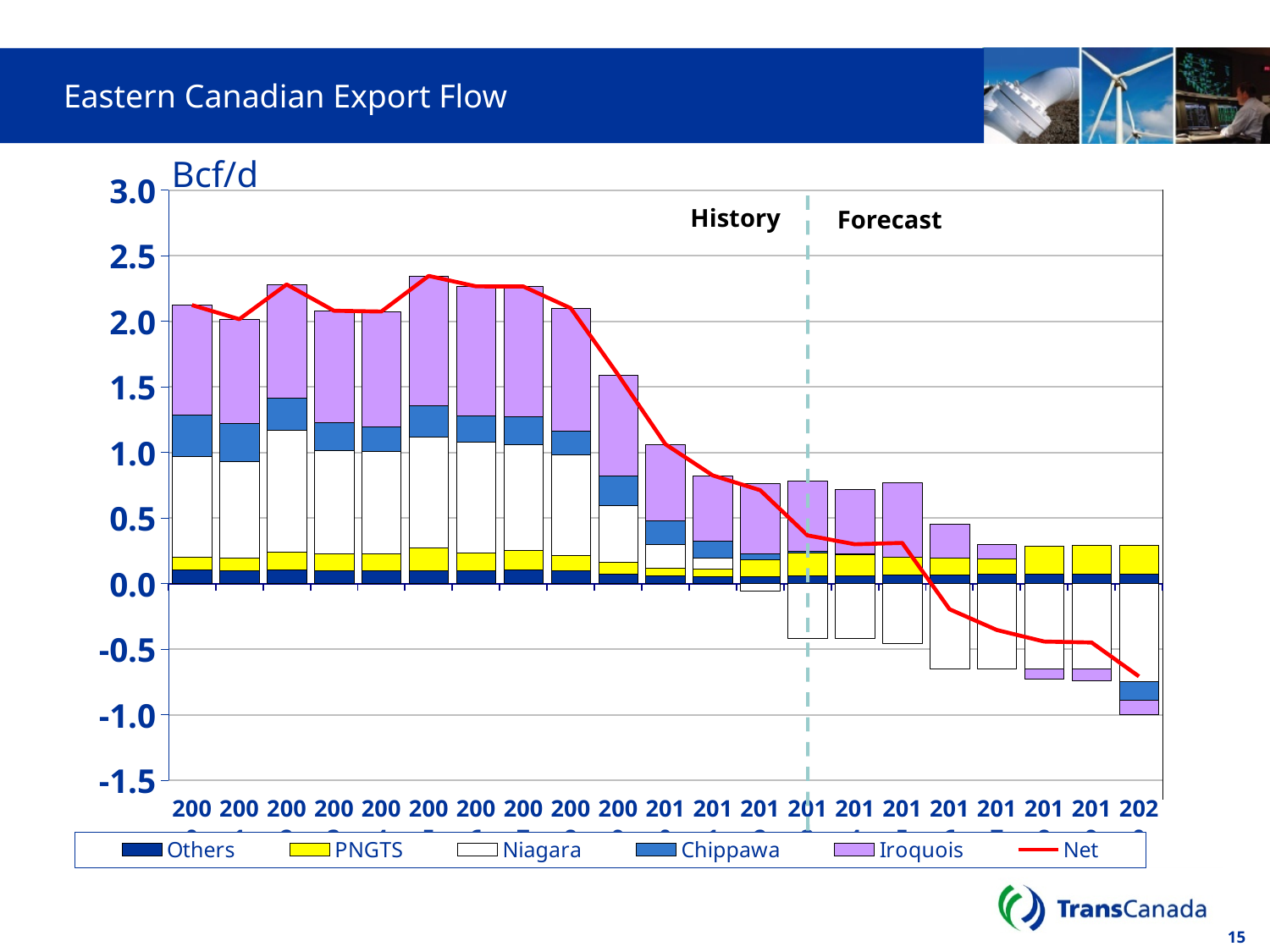
What kind of chart is shown on the slide? stacked bar chart with a line Which series is plotted as a red line rather than as bars? Net How many series does the legend list? 6 Is the Net value for the leftmost year greater or less than 1.5? greater Does the Net line rise or fall overall from the leftmost year to the rightmost year? fall Is the Net value at the dashed History/Forecast boundary greater or less than 1.0? less How many bars (years) are plotted along the x axis? 21 Is the Net value for the leftmost year larger or smaller than the Net value for the rightmost year? larger Which series has the most negative values in the Forecast period? Niagara Which series forms the largest segment of the leftmost bar? Iroquois What is the title of the chart? Eastern Canadian Export Flow Is the Net value for the rightmost year greater or less than -0.5? less